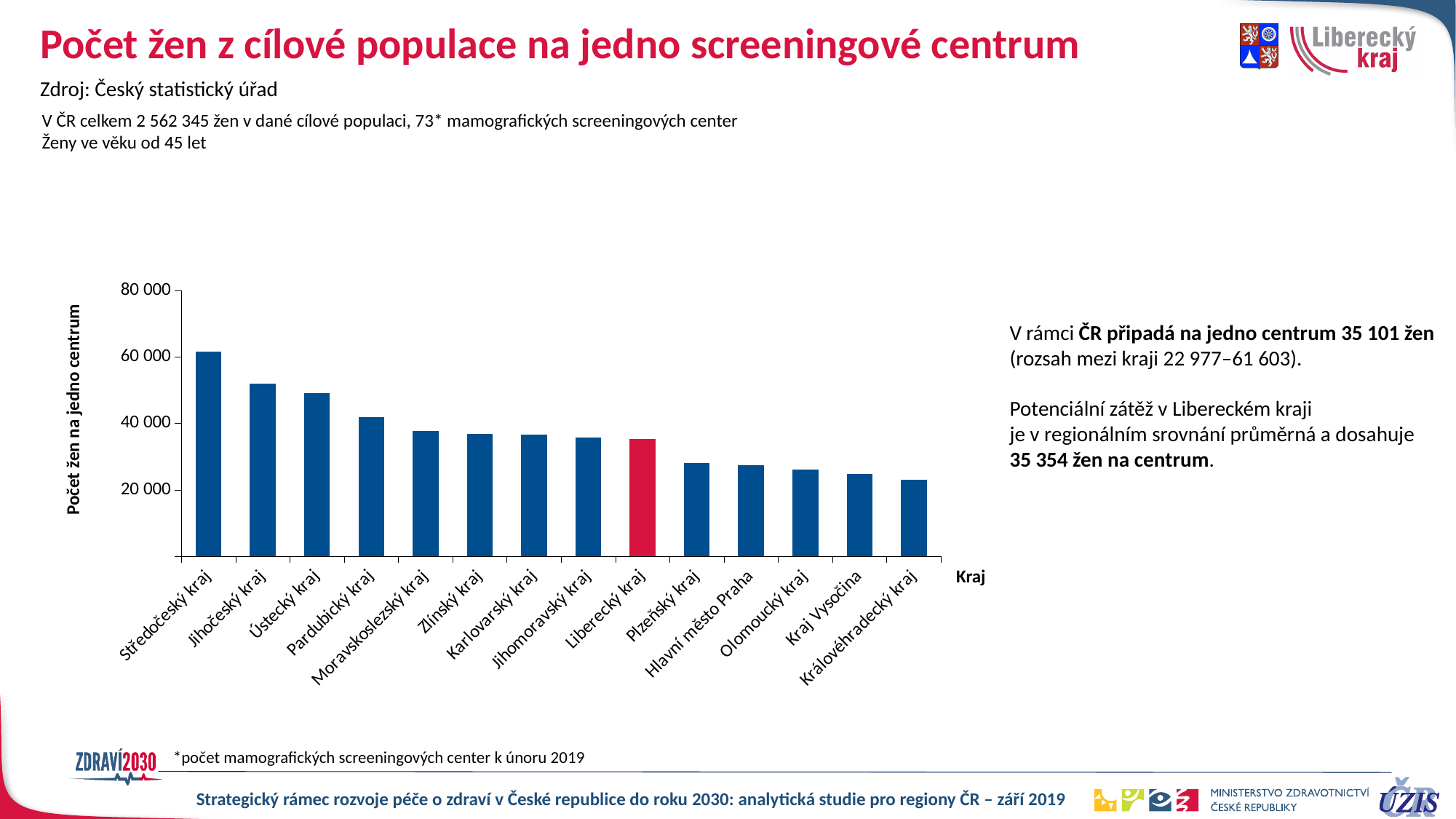
Which region has the lowest number of women per screening centre? Královéhradecký kraj Is the value for Středočeský kraj greater or less than 40 000? greater According to the slide, how many women per centre does Liberecký kraj have? 35 354 Which region has the highest number of women per screening centre? Středočeský kraj Is the value for Plzeňský kraj greater or less than 20 000? greater Is the value for Moravskoslezský kraj greater or less than 40 000? less What kind of chart is shown on the slide? bar chart Which has a higher value, Jihočeský kraj or Pardubický kraj? Jihočeský kraj Do the bar values rise or fall from left to right along the x axis? fall Which region's bar is highlighted in red? Liberecký kraj How many regions (kraje) are shown on the x axis of the chart? 14